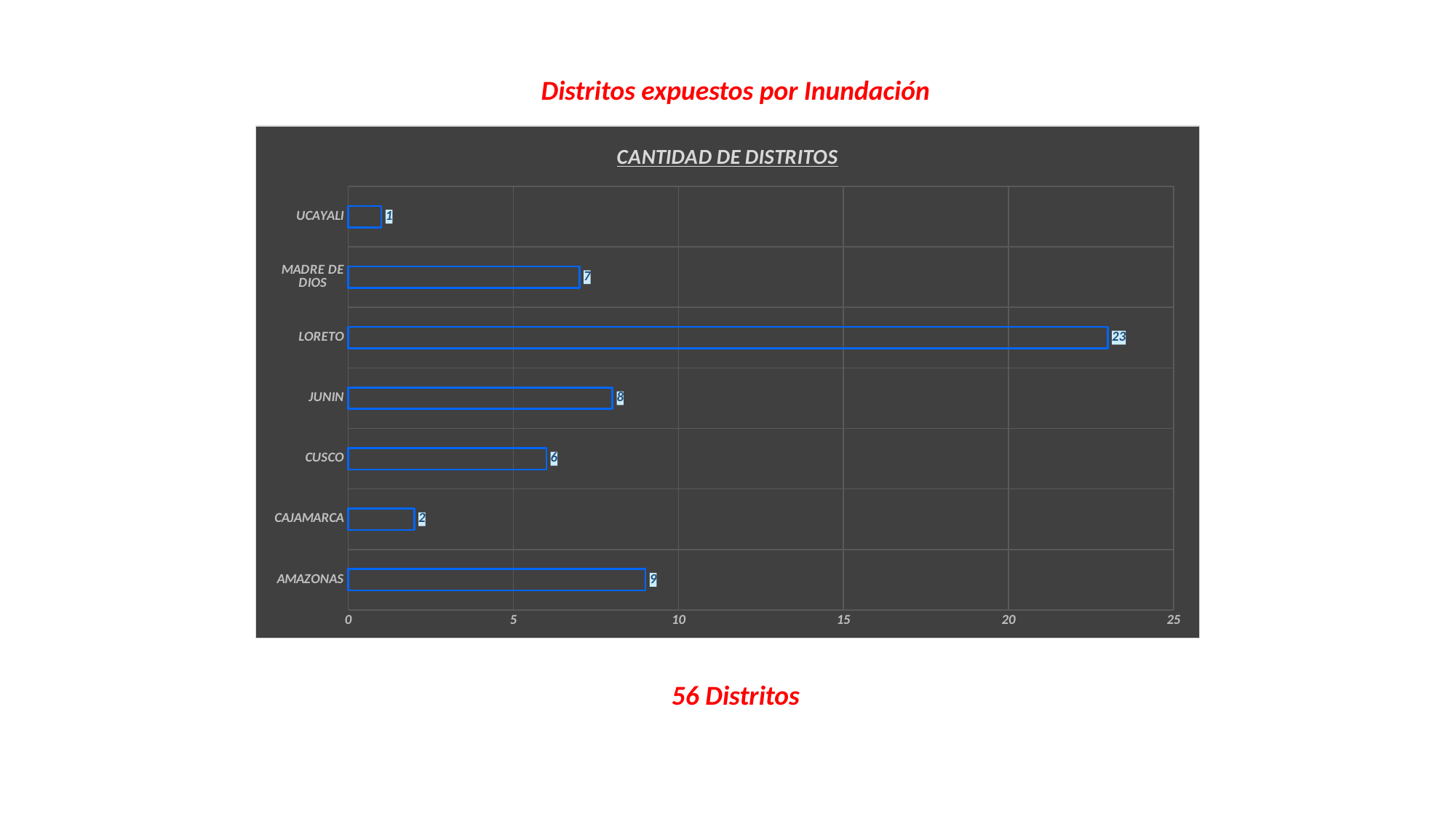
What is the value for AMAZONAS? 9 Which is larger, the value for CUSCO or the value for CAJAMARCA? CUSCO What is the value for MADRE DE DIOS? 7 Which category has the highest value? LORETO What is the value for LORETO? 23 What is the difference between the values for LORETO and JUNIN? 15 Which category has the lowest value? UCAYALI What kind of chart is shown? bar chart Is the value for LORETO greater or less than 20? greater What is the title of the chart? CANTIDAD DE DISTRITOS What is the maximum value shown on the horizontal axis? 25 How many categories are shown in the chart? 7